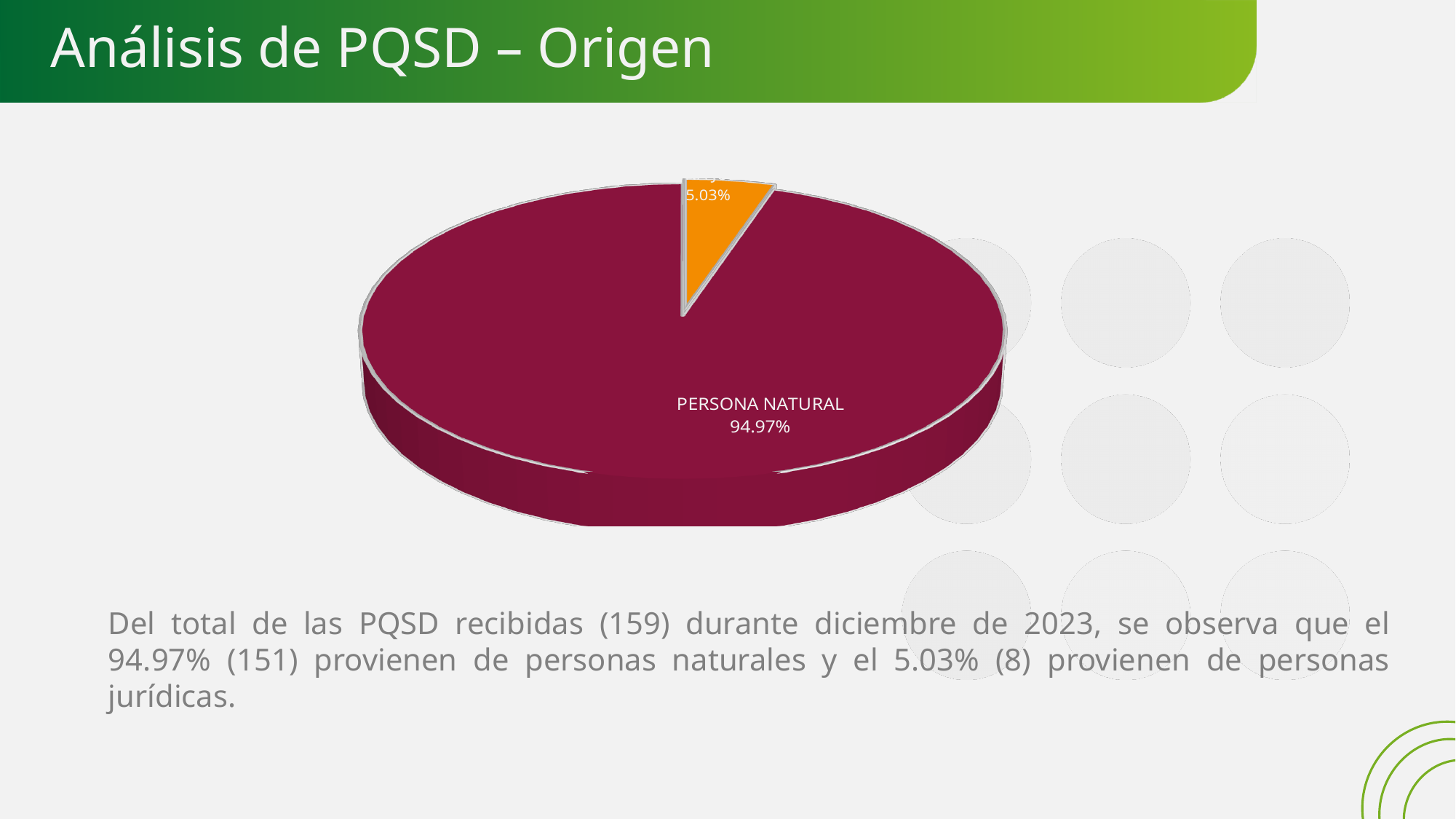
Which slice of the pie is the largest? PERSONA NATURAL What colour is the PERSONA NATURAL slice of the pie? Dark red (maroon) Is the share for PERSONA NATURAL greater or less than 90%? greater Which is larger, the PERSONA NATURAL slice or the orange slice? PERSONA NATURAL What do the two slice percentages (94.97% and 5.03%) add up to? 100% What percentage is shown on the small orange slice of the pie? 5.03% What kind of chart is shown on the slide? Pie chart How many slices does the pie chart have? 2 What is the title of the slide containing the pie chart? Análisis de PQSD – Origen What share of the pie does PERSONA NATURAL represent? 94.97% What is the difference in percentage points between the PERSONA NATURAL slice (94.97%) and the orange slice (5.03%)? 89.94